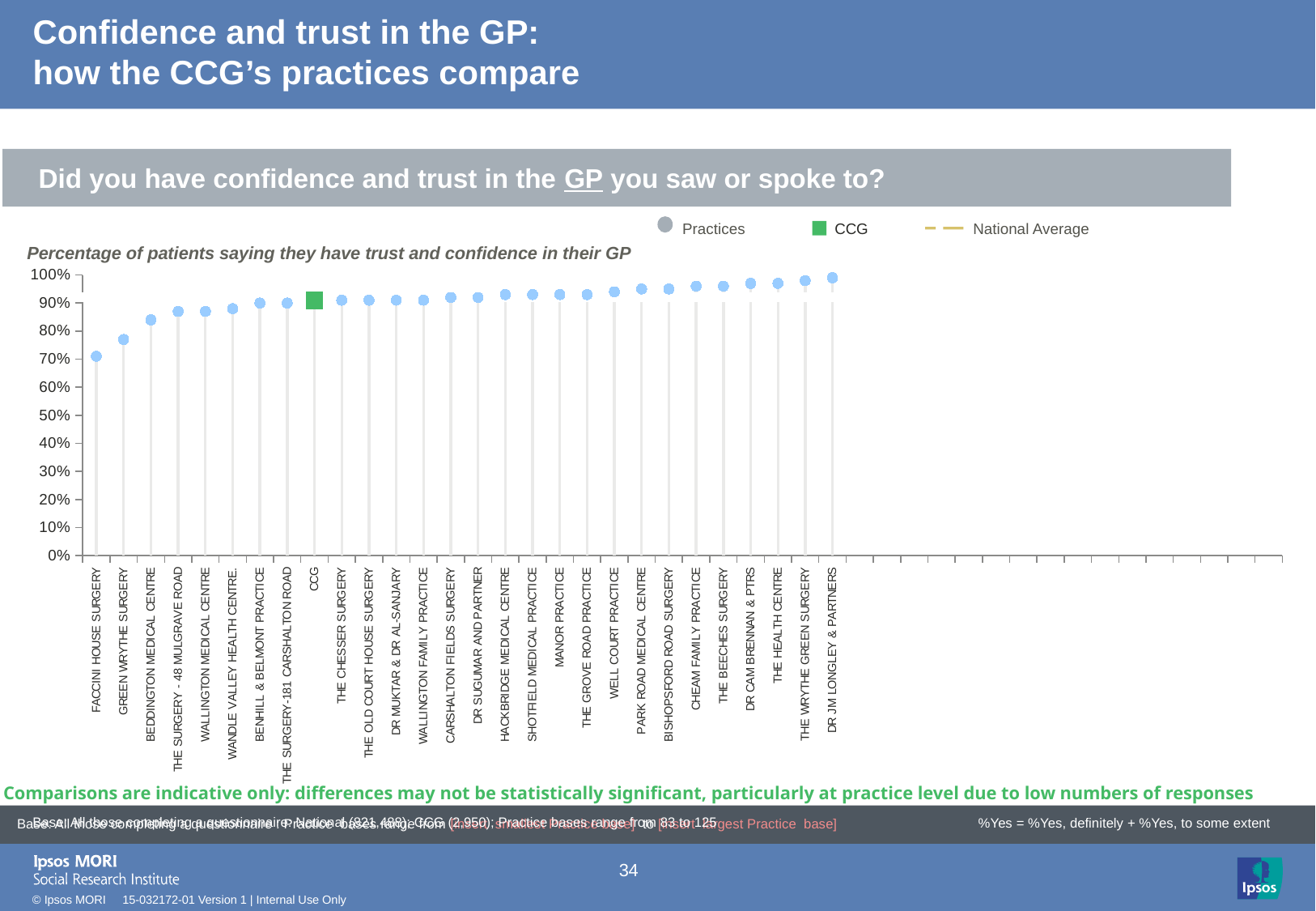
How many entries does the chart legend list? 3 Which practice has the highest percentage of patients saying they have trust and confidence in their GP? DR JM LONGLEY & PARTNERS Is the value for DR JM LONGLEY & PARTNERS greater or less than 90%? greater How many practices (excluding the CCG marker) are plotted on the chart? 27 Which practice has the lowest percentage of patients saying they have trust and confidence in their GP? FACCINI HOUSE SURGERY Do the plotted values rise or fall moving from left to right along the x axis? rise What is the subtitle printed above the chart describing what is plotted? Percentage of patients saying they have trust and confidence in their GP Is the value for FACCINI HOUSE SURGERY greater or less than 80%? less Is the value for BEDDINGTON MEDICAL CENTRE greater or less than 80%? greater Which has a higher value, FACCINI HOUSE SURGERY or GREEN WRYTHE SURGERY? GREEN WRYTHE SURGERY What colour is the marker used for the CCG in the chart? green